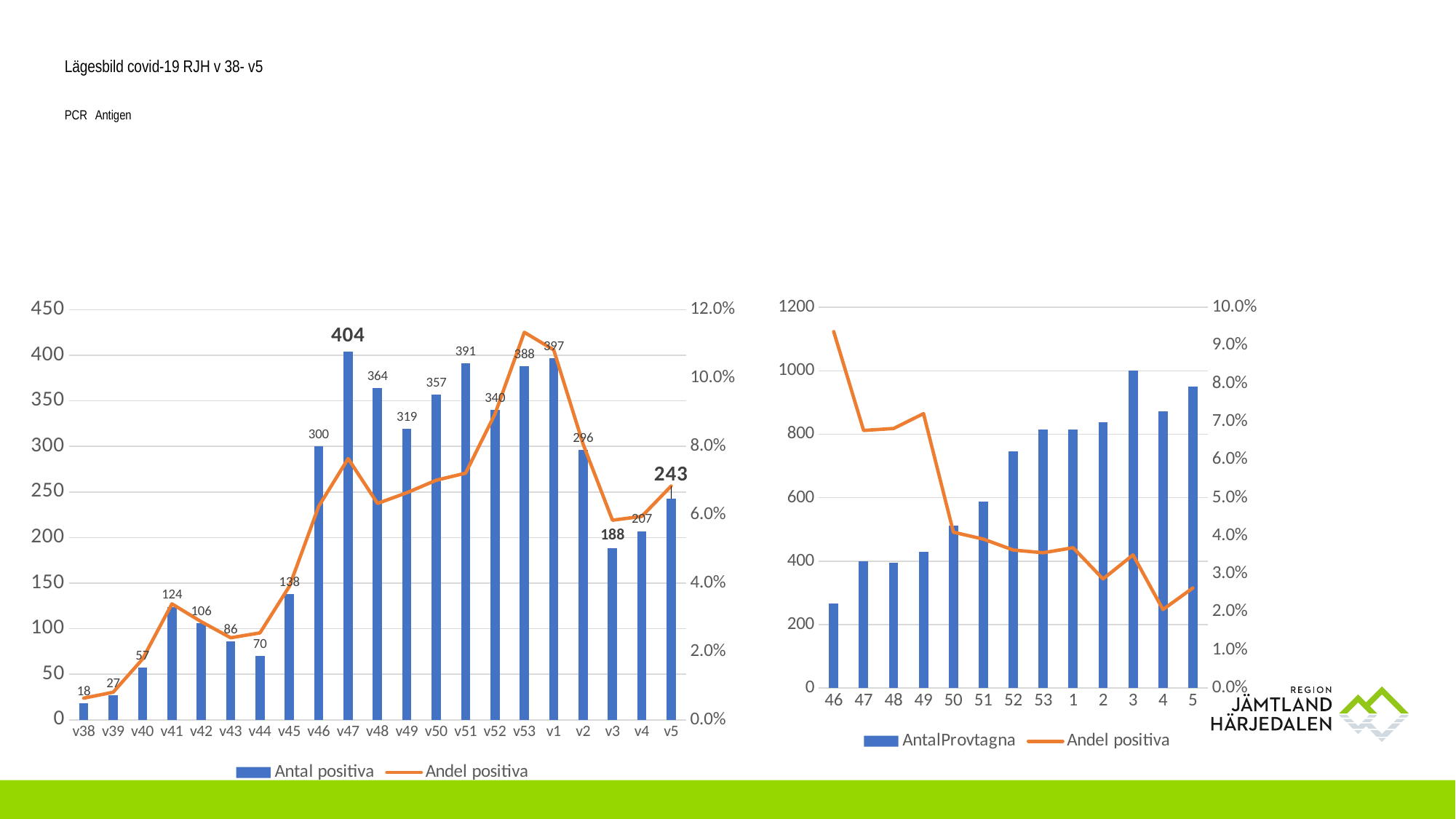
In the right chart, is the AntalProvtagna value for week 46 greater or less than 400? less In the left chart, what is the difference in Antal positiva between v47 and v3? 216 In the left chart, which is larger, Antal positiva for v51 or for v53? v51 How many series does the legend of the right chart list? 2 In the left chart, what is the value of Antal positiva for v47? 404 In the left chart, which week has the highest Antal positiva? v47 In the left chart, what is the value of Antal positiva for v5? 243 In the left chart, which week has the lowest Antal positiva? v38 In the right chart, which week has the highest AntalProvtagna bar? 3 How many weeks are shown on the x axis of the left chart? 21 In the left chart, what is the value of Antal positiva for v41? 124 In the right chart, does the Andel positiva line generally rise or fall from week 46 to week 5? fall